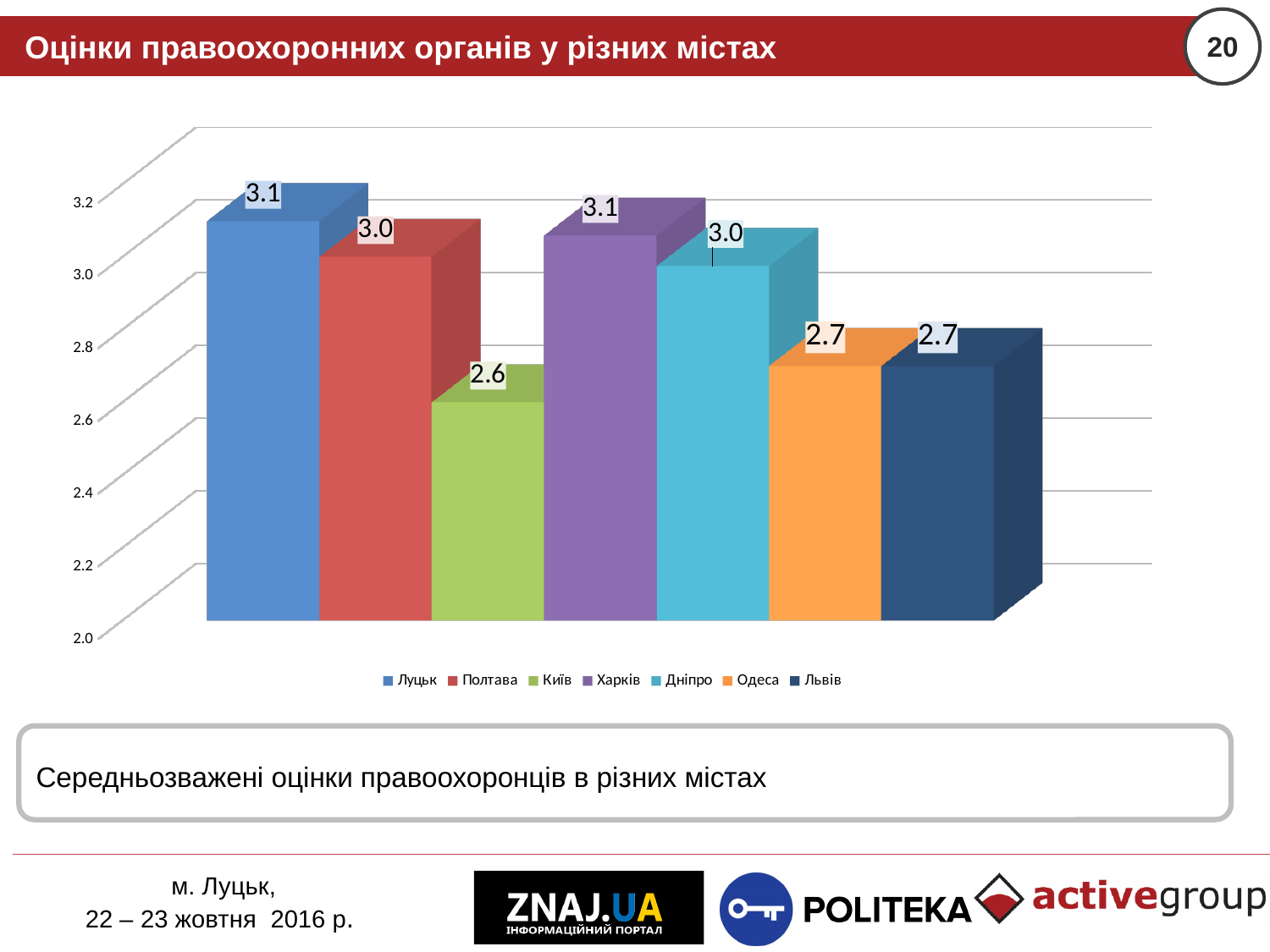
What kind of chart is shown on the slide? bar chart How many entries does the legend list? 7 What is the value for Київ? 2.6 Which city has the lowest value? Київ What is the value for Дніпро? 3.0 Which is larger, the value for Полтава or the value for Київ? Полтава How many cities are shown in the chart? 7 What is the difference between the values for Харків and Львів? 0.4 What is the value for Луцьк? 3.1 What is the difference between the values for Луцьк and Київ? 0.5 Is the value for Київ greater or less than 2.8? less What is the value for Одеса? 2.7